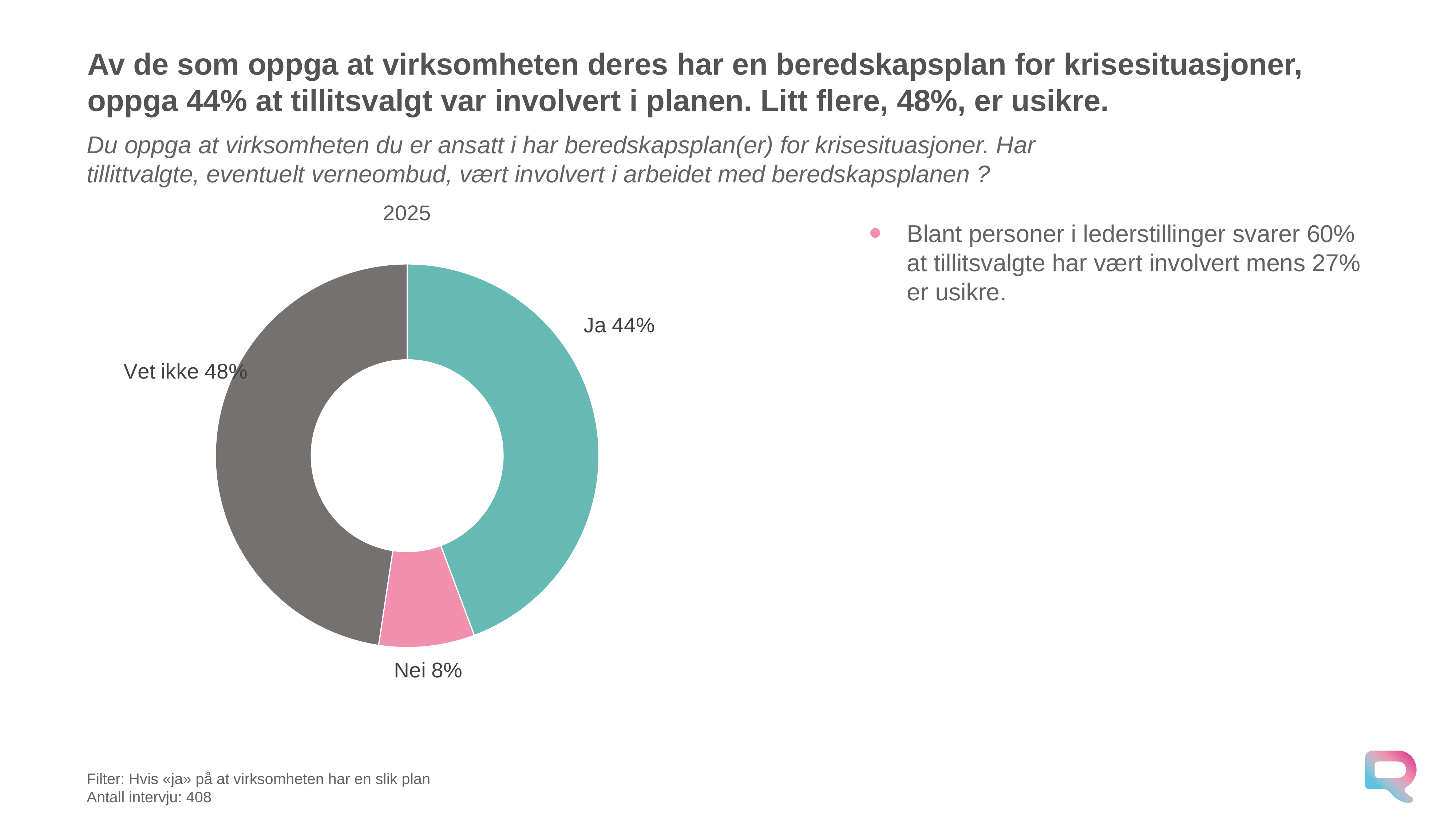
What is the title shown above the chart? 2025 What is the difference in percentage points between "Vet ikke" and "Ja"? 4 What percentage of respondents answered "Vet ikke"? 48% Which category has the largest share of the chart? Vet ikke What kind of chart is shown on the slide? Pie chart (donut) What percentage of respondents answered "Ja"? 44% Which category has the smallest share of the chart? Nei Which is larger, the share for "Ja" or the share for "Nei"? Ja How many categories are shown in the chart? 3 What colour is the "Nei" slice? Pink What percentage of respondents answered "Nei"? 8% What is the difference in percentage points between "Ja" and "Nei"? 36